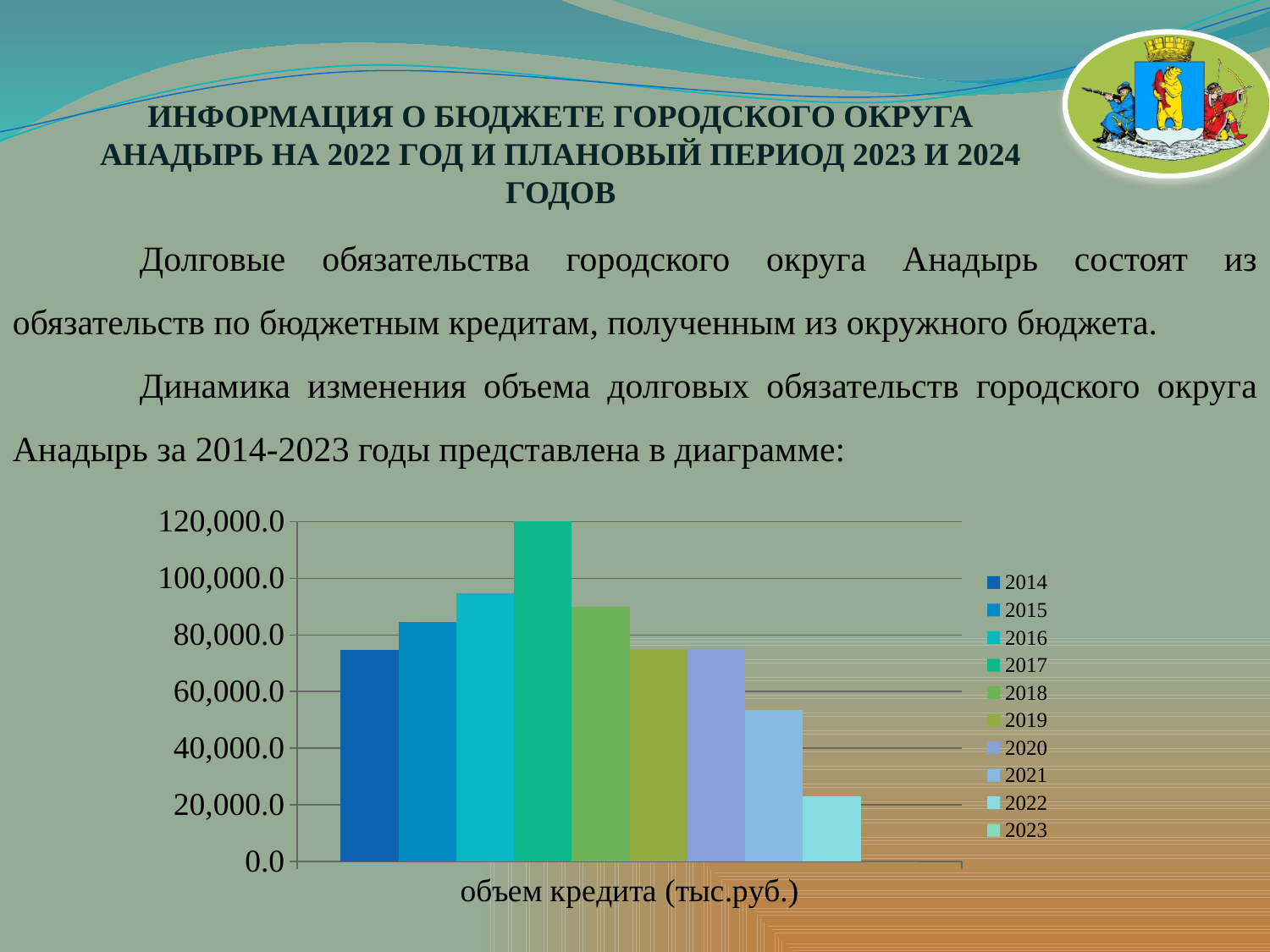
Is the value for 2018 greater or less than 80,000.0? greater What is the value for 2017 in the chart? 120,000.0 Is the value for 2016 greater or less than 100,000.0? less Is the value for 2021 greater or less than 60,000.0? less Which is larger, the value for 2015 or the value for 2021? 2015 What is the label shown under the x axis of the chart? объем кредита (тыс.руб.) Do the values rise or fall from 2017 to 2022? fall How many series does the legend list? 10 Which year has the highest bar in the chart? 2017 What kind of chart is shown on the slide? bar chart